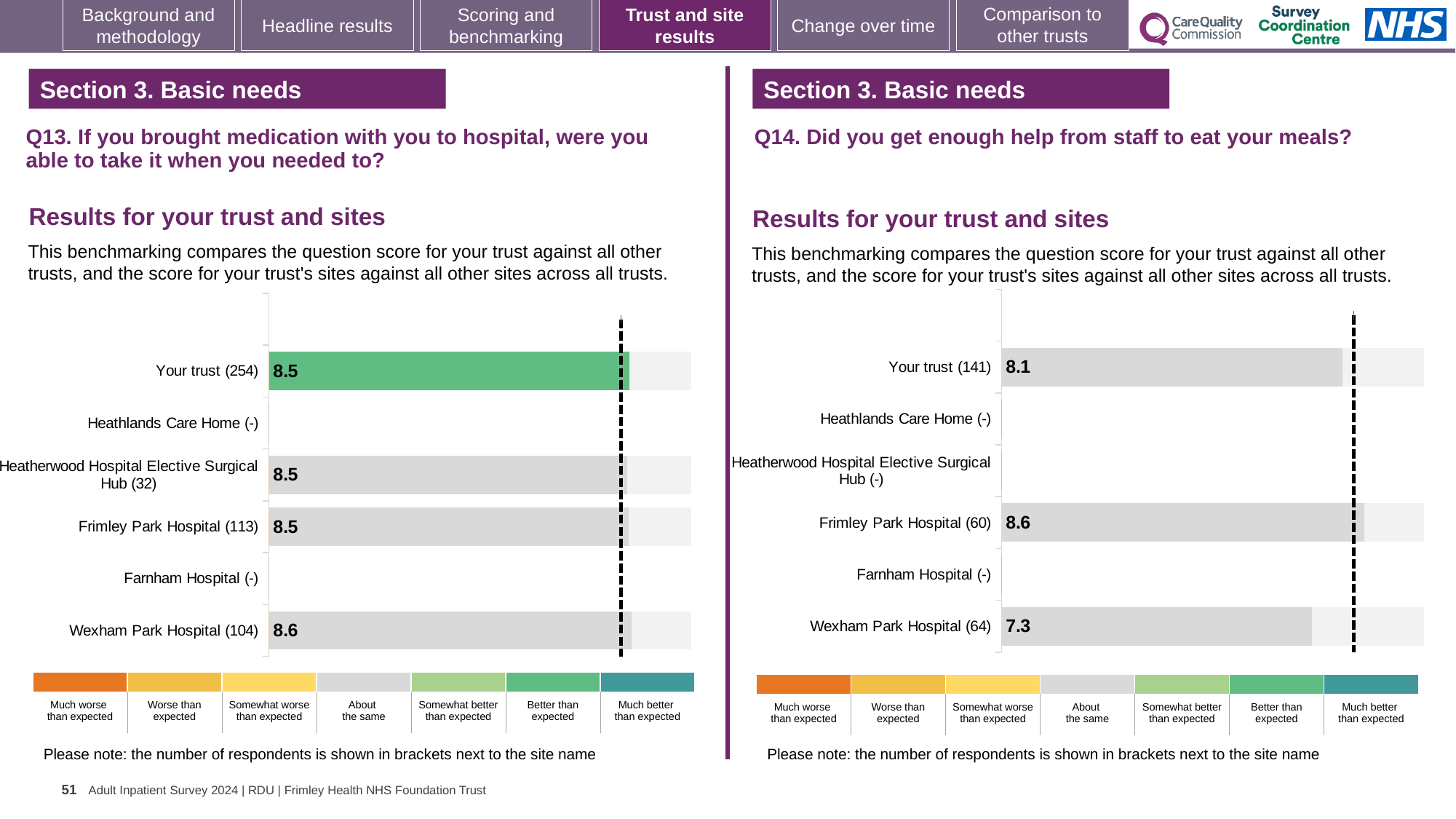
On the Q14 chart (right), which site has the lowest score? Wexham Park Hospital On the Q13 chart (left), which site has the highest score? Wexham Park Hospital On the Q14 chart (right), what is the difference between the scores for Frimley Park Hospital and Wexham Park Hospital? 1.3 On the Q14 chart (right), which has the higher score, Frimley Park Hospital or Your trust? Frimley Park Hospital On the Q14 chart (right), how many respondents are shown in brackets for Frimley Park Hospital? 60 On the Q14 chart (right), what is the score for Wexham Park Hospital? 7.3 What kind of chart is used on the Q13 chart (left)? Bar chart On the Q13 chart (left), what is the score for Wexham Park Hospital? 8.6 On the Q13 chart (left), what is the difference between the scores for Wexham Park Hospital and Frimley Park Hospital? 0.1 On the Q14 chart (right), what is the score for Your trust? 8.1 On the Q13 chart (left), what is the score for Your trust? 8.5 On the Q13 chart (left), how many site rows are listed below Your trust? 5